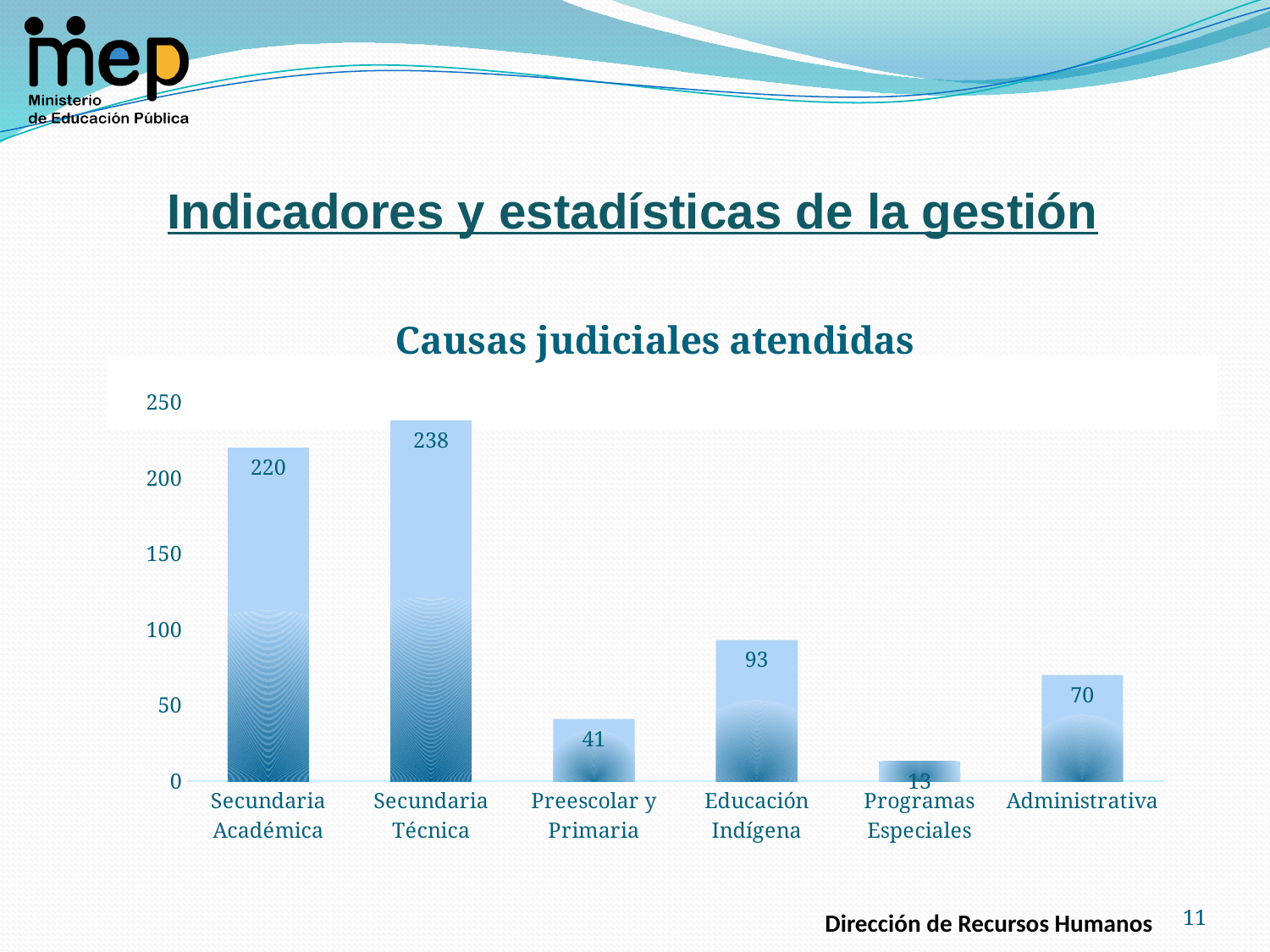
Which is larger, the value for Administrativa or the value for Preescolar y Primaria? Administrativa Is the value for Educación Indígena greater or less than 100? less What is the value for Secundaria Técnica? 238 What is the value for Administrativa? 70 What is the difference between the values for Educación Indígena and Preescolar y Primaria? 52 What is the value for Educación Indígena? 93 How many categories are shown in the chart? 6 Which category has the lowest value? Programas Especiales Which category has the highest value? Secundaria Técnica What is the value for Secundaria Académica? 220 What type of chart is shown on the slide? bar chart What is the difference between the values for Secundaria Técnica and Secundaria Académica? 18